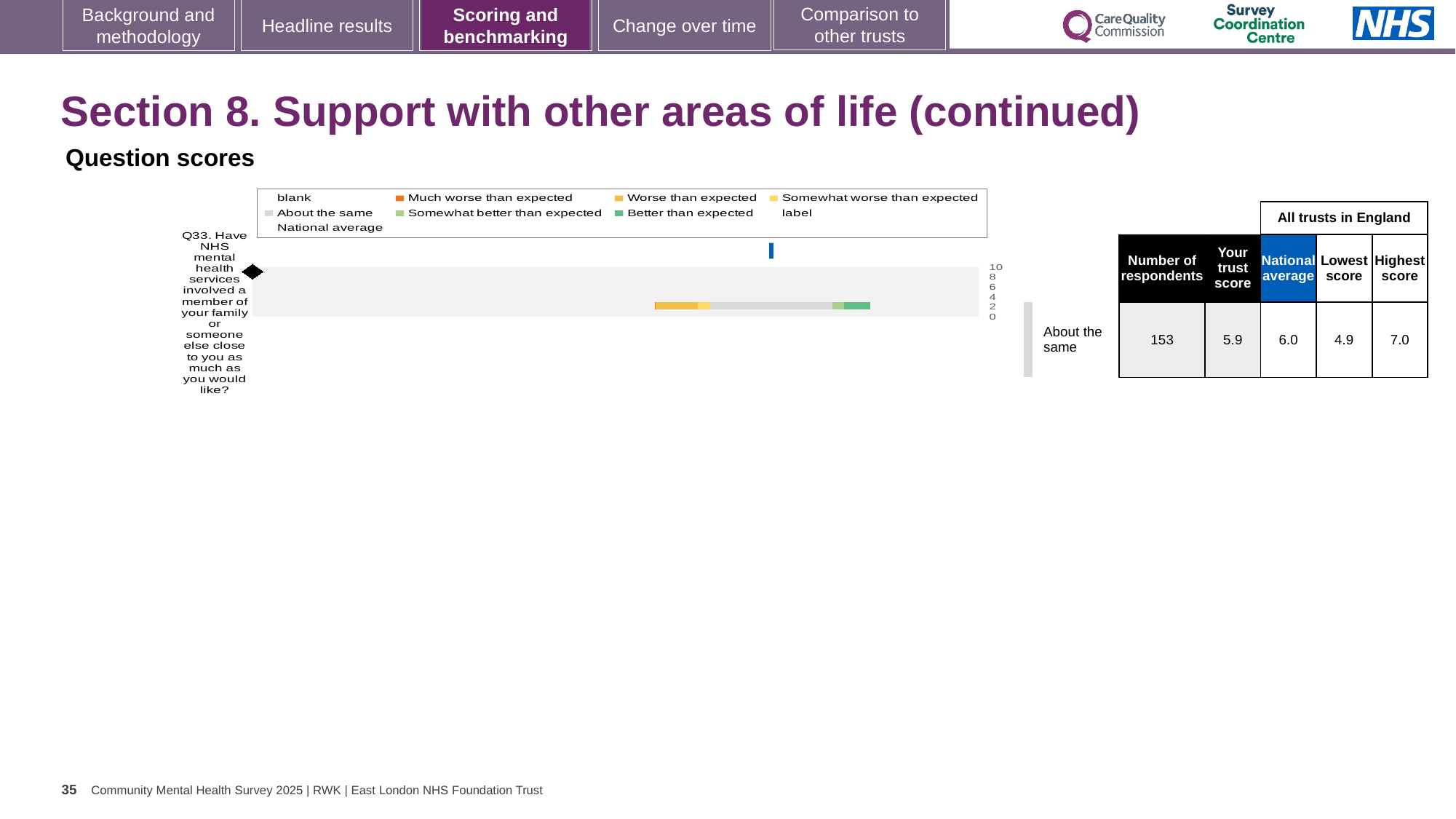
What kind of chart is shown on the slide for Q33? bar chart What is the trust score for Q33 shown in the table beside the chart? 5.9 What is the highest score among all trusts in England for Q33? 7.0 What is the lowest score among all trusts in England for Q33? 4.9 How many survey questions are plotted in the chart? 1 What is the national average for Q33 shown in the table beside the chart? 6.0 Which question number is plotted in the chart? Q33 How many respondents answered Q33? 153 Which is larger for Q33, the trust score or the national average? national average Is the national average marker for Q33 on the chart greater or less than 4? greater What is the difference between the highest score and the lowest score for Q33? 2.1 What benchmark category label is shown to the right of the Q33 bar? About the same